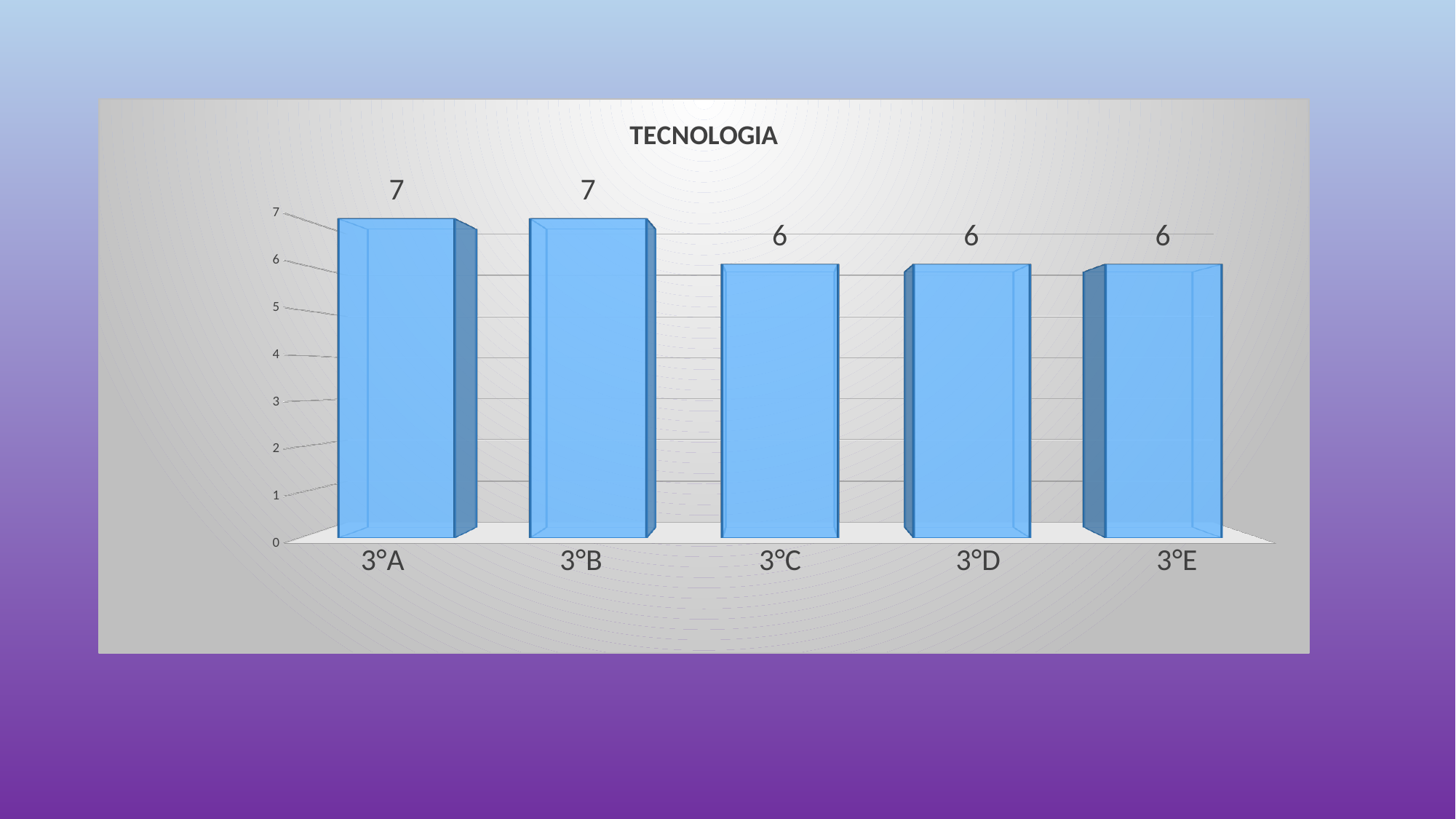
How many categories are shown on the x axis? 5 Do the values rise or fall from 3°A to 3°E? fall What is the value for 3°E? 6 Is the value for 3°B greater or less than 5? greater What kind of chart is this? bar chart What is the highest value shown on the vertical axis? 7 What is the value for 3°D? 6 Which is larger, the value for 3°A or the value for 3°C? 3°A What is the difference between the values for 3°B and 3°D? 1 What is the value for 3°A? 7 What is the value for 3°C? 6 What is the title of the chart? TECNOLOGIA